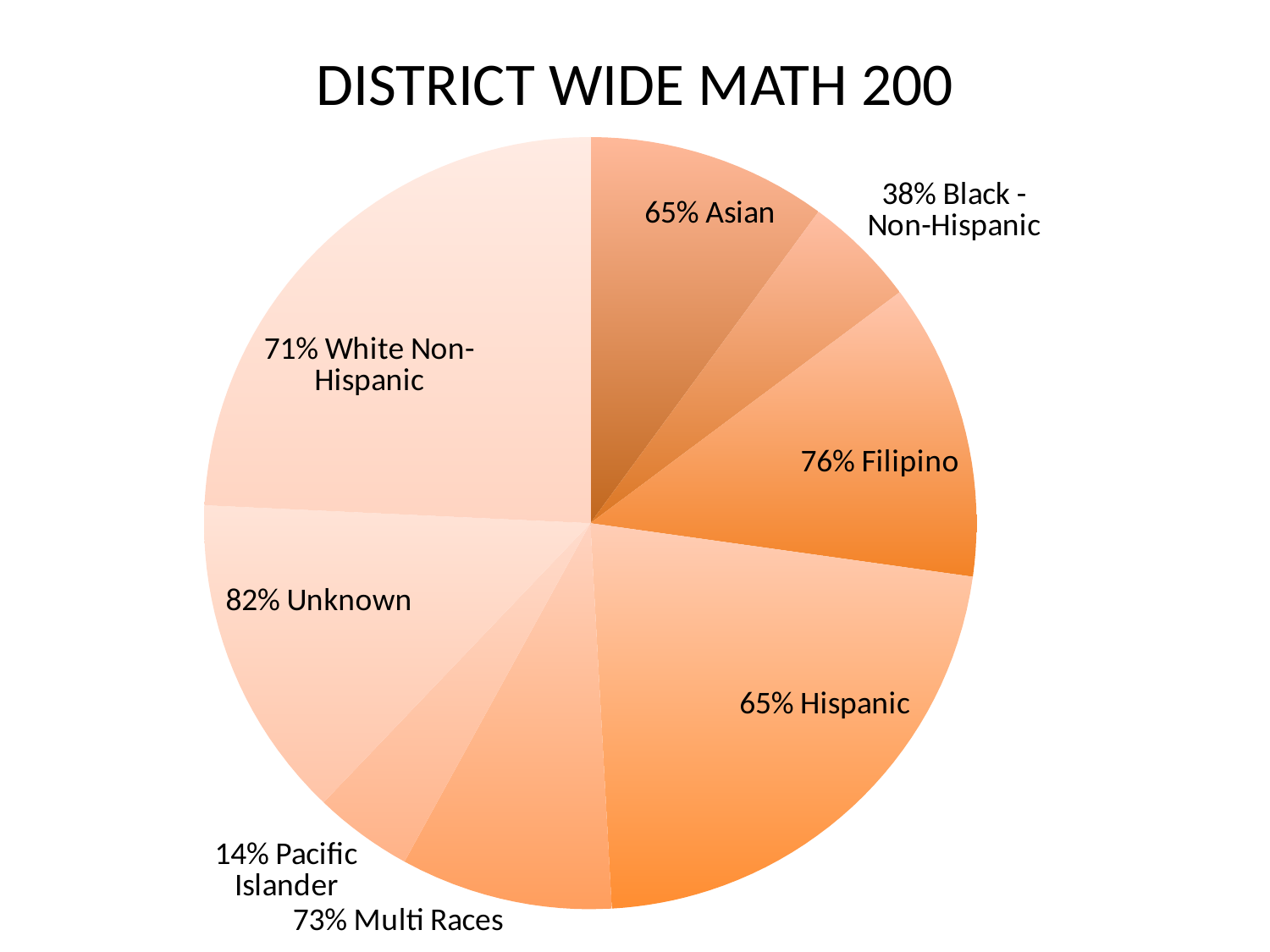
What value is shown for Filipino? 76% What value is shown for Black - Non-Hispanic? 38% What is the difference between the labelled values for Unknown and Pacific Islander? 68 percentage points What value is shown for Unknown? 82% Which has the larger labelled value, Filipino or Multi Races? Filipino How many categories are shown on the pie chart? 8 Which category has the lowest labelled value? Pacific Islander Which category has the highest labelled value? Unknown What value is shown for Asian on the pie chart? 65% What value is shown for Pacific Islander? 14% What is the title of the chart? DISTRICT WIDE MATH 200 What kind of chart is shown on the slide? Pie chart